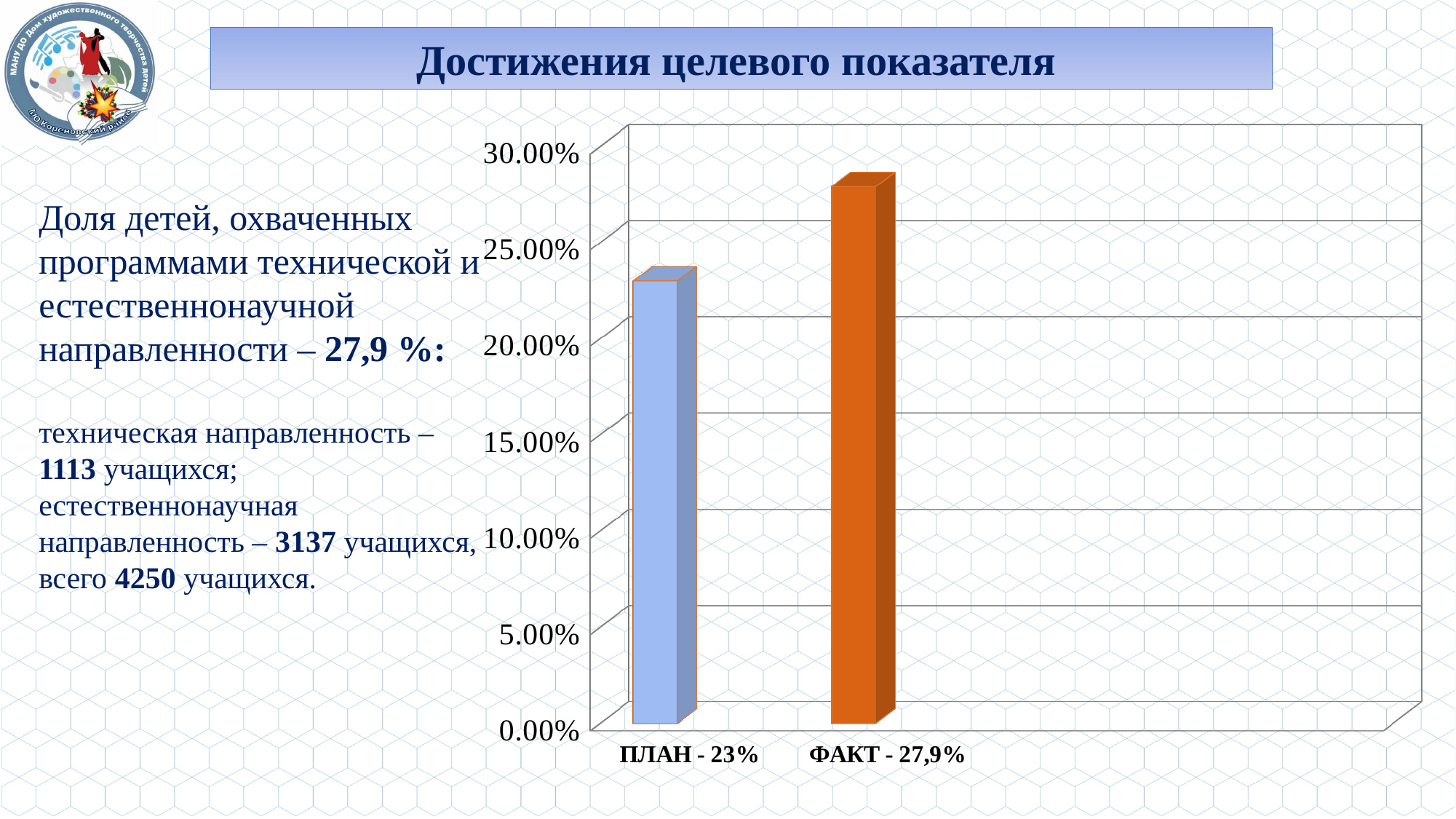
What is the value for ПЛАН according to the category label? 23% What is the value for ФАКТ according to the category label? 27,9% Which category has the highest value in the chart? ФАКТ Is the value for ПЛАН greater or less than 25.00%? less What is the highest tick value shown on the vertical axis? 30.00% How many bars are plotted in the chart? 2 Do the values rise or fall from ПЛАН to ФАКТ along the x axis? rise What colour is the bar for ФАКТ? orange Is the value for ФАКТ greater or less than 25.00%? greater What kind of chart is shown on the slide? bar chart Which category has the lowest value in the chart? ПЛАН Which category has the higher bar, ПЛАН or ФАКТ? ФАКТ